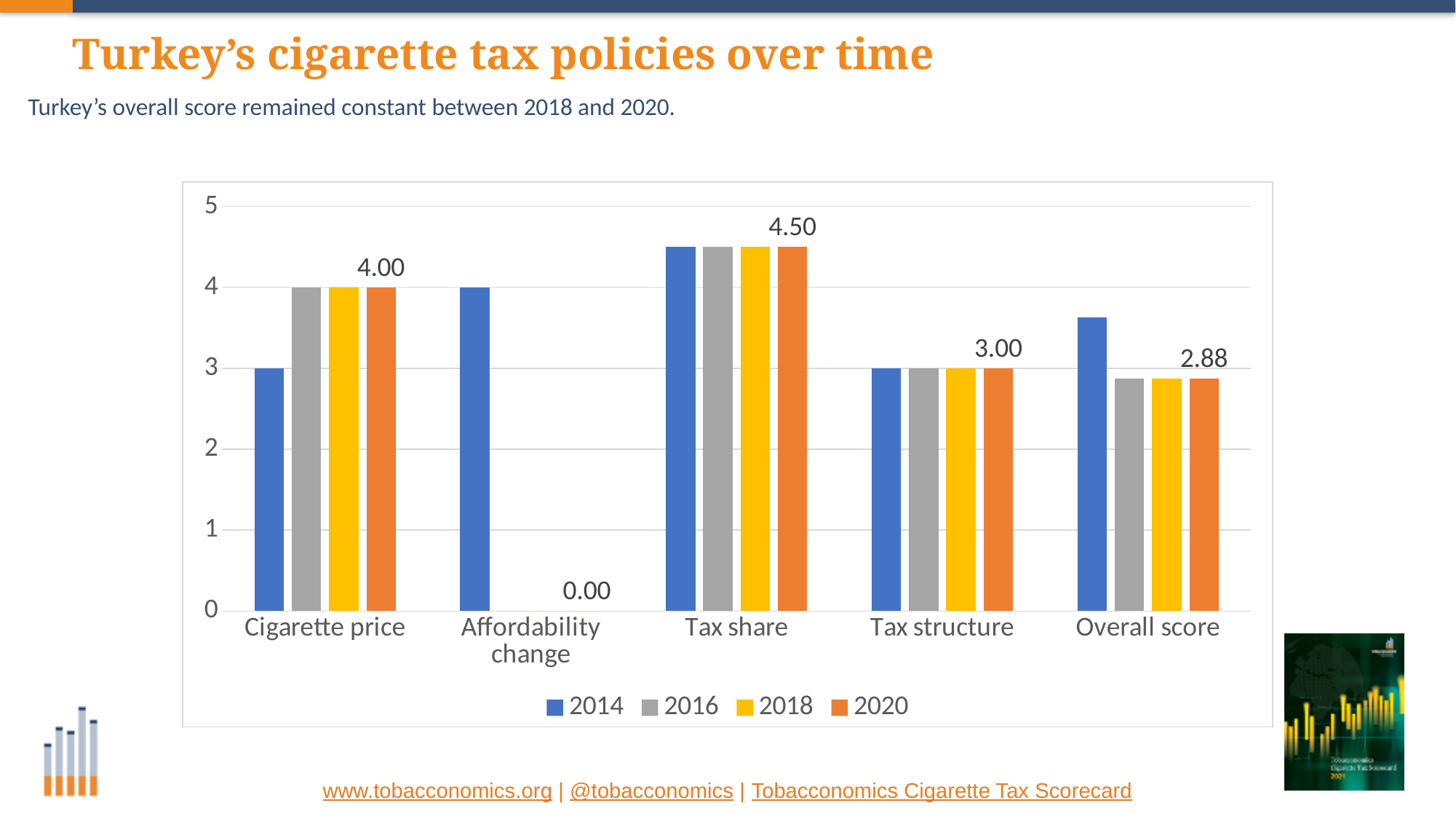
Which category has the lowest 2020 value? Affordability change Which is larger for Cigarette price: the 2014 value or the 2020 value? 2020 What kind of chart is shown on the slide? Bar chart How many categories are shown on the x axis? 5 Is the 2014 value for Overall score greater or less than 3? greater What is the 2020 value for Overall score? 2.88 Which category has the highest 2020 value? Tax share What is the difference between the 2020 values for Tax share and Tax structure? 1.50 What is the 2020 value for Tax share? 4.50 How many series does the legend list? 4 What is the 2020 value for Tax structure? 3.00 What is the 2020 value for Affordability change? 0.00